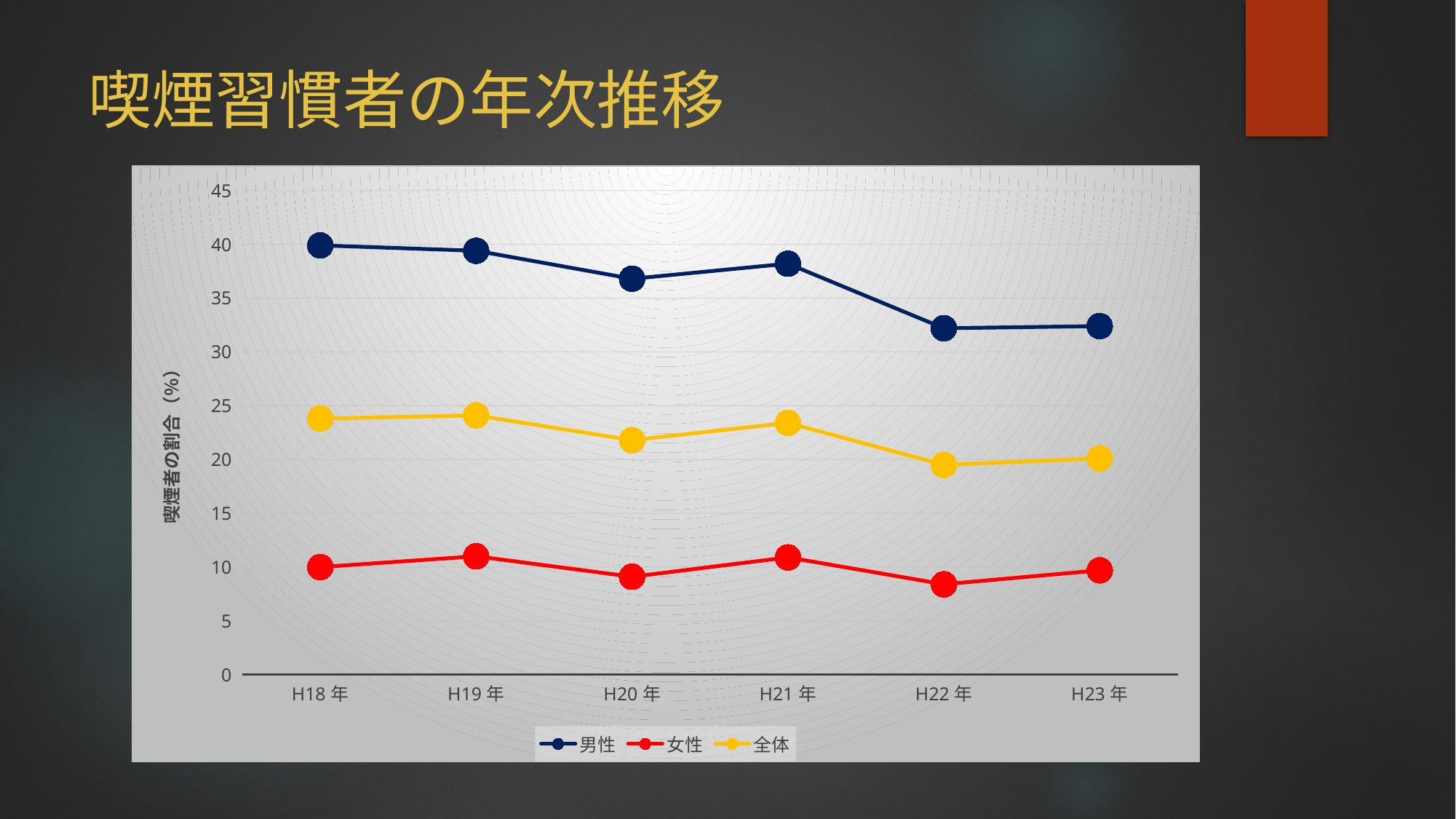
How many series does the legend list? 3 Is the value for 女性 in H22年 greater or less than 10? less Does the 男性 series overall rise or fall from H18年 to H23年? fall In which year is the value for 女性 lowest? H22年 Is the value for 全体 in H18年 greater or less than 25? less What kind of chart is shown on the slide? line chart Is the value for 男性 in H22年 greater or less than 35? less How many years are plotted along the x axis? 6 Which is larger for 男性: the value in H20年 or the value in H21年? H21年 Which is larger for 全体: the value in H20年 or the value in H21年? H21年 What is the label on the vertical axis? 喫煙者の割合（%）